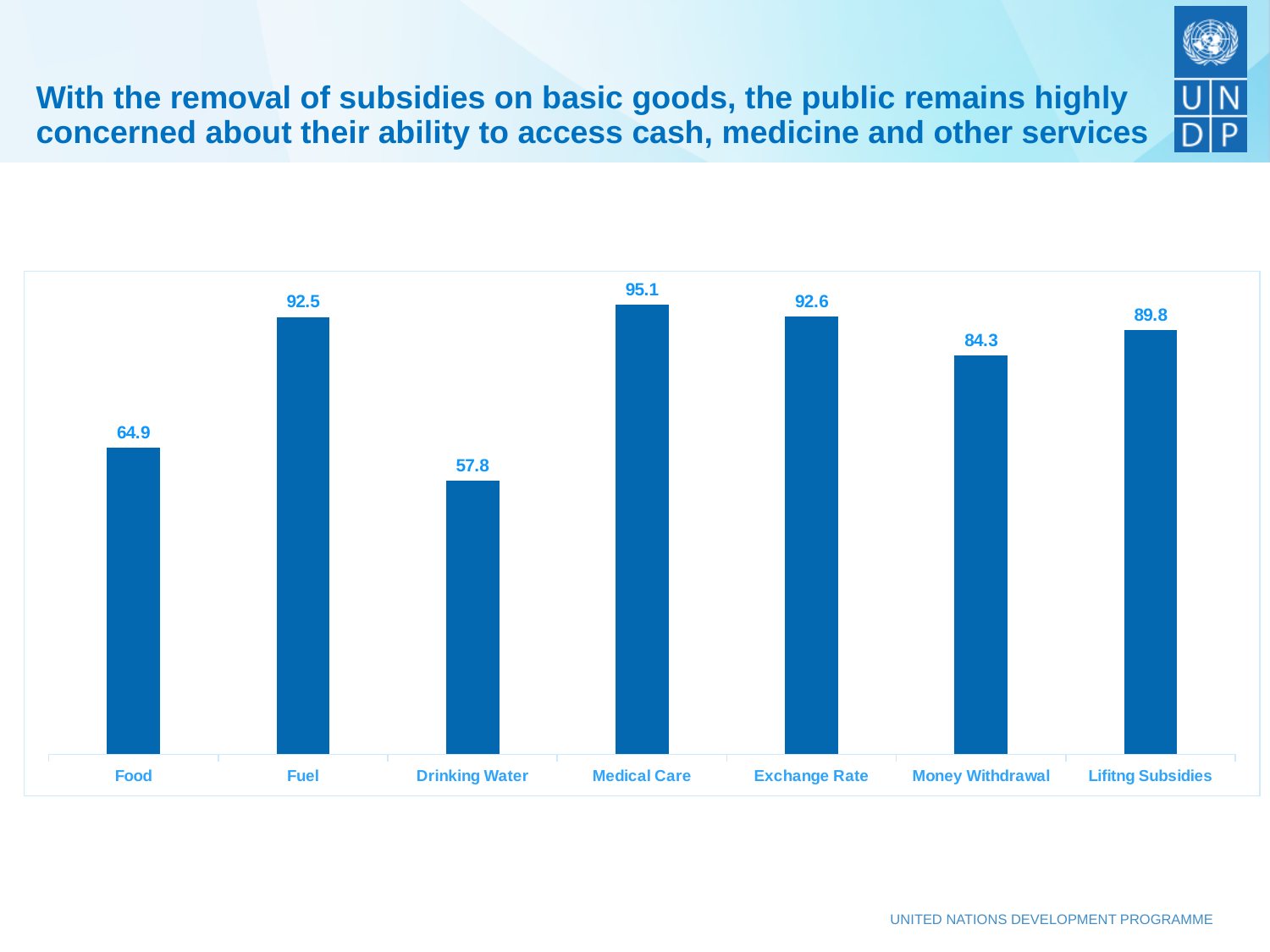
Which category has the highest value? Medical Care What is the value for Medical Care? 95.1 What is the value for Money Withdrawal? 84.3 Which category has the lowest value? Drinking Water What is the difference between the values for Fuel and Drinking Water? 34.7 How many categories are shown on the chart? 7 What colour are the bars in the chart? Blue What kind of chart is shown on the slide? Bar chart What is the difference between the values for Medical Care and Food? 30.2 What is the value for Lifitng Subsidies? 89.8 Which is larger, the value for Money Withdrawal or the value for Lifitng Subsidies? Lifitng Subsidies What is the value for Food? 64.9